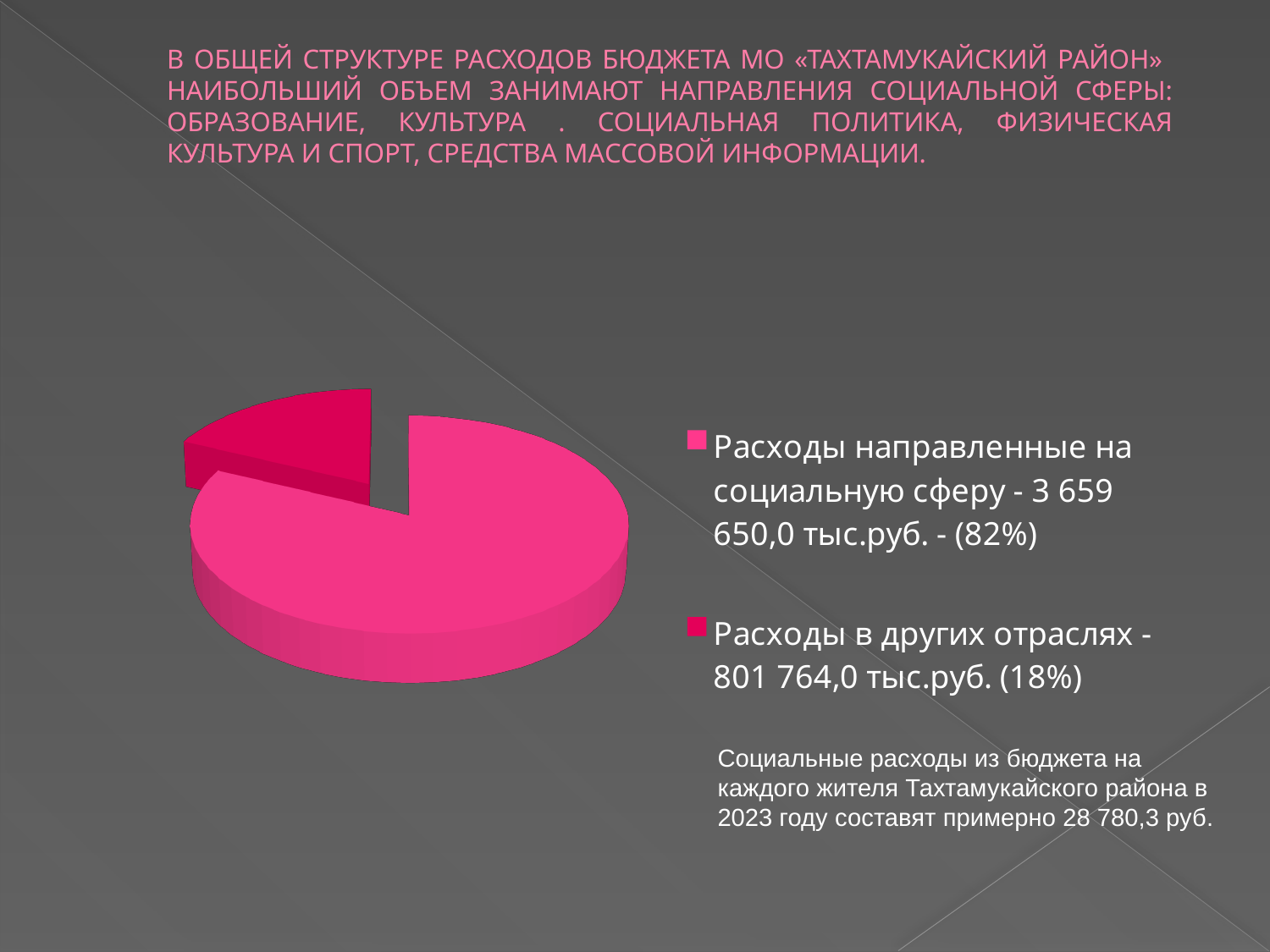
How many entries does the legend of the pie chart list? 2 What share of the pie does "Расходы направленные на социальную сферу" take? 82% What share of the pie does "Расходы в других отраслях" take? 18% What is the value for "Расходы направленные на социальную сферу"? 3 659 650,0 тыс.руб. What is the total of the two values shown in the pie chart legend? 4 461 414,0 тыс.руб. What is the difference between "Расходы направленные на социальную сферу" and "Расходы в других отраслях" in тыс.руб.? 2 857 886,0 тыс.руб. What kind of chart is shown on the slide? Pie chart Which slice of the pie chart is the largest? Расходы направленные на социальную сферу Which is larger: "Расходы направленные на социальную сферу" or "Расходы в других отраслях"? Расходы направленные на социальную сферу What is the value for "Расходы в других отраслях"? 801 764,0 тыс.руб. How many slices does the pie chart have? 2 Which slice of the pie chart is the smallest? Расходы в других отраслях